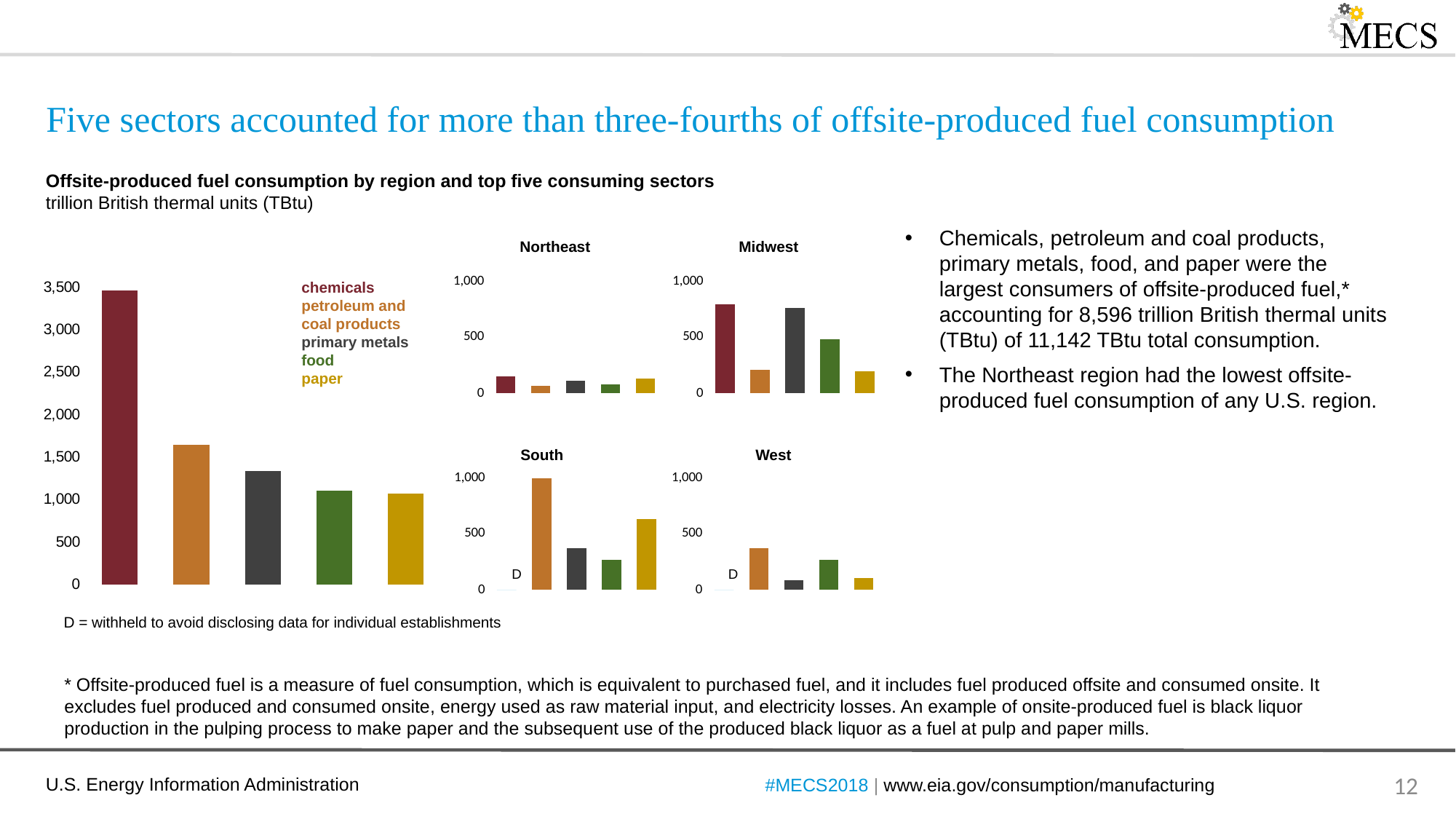
In the large chart on the left, which sector has the highest offsite-produced fuel consumption? chemicals In the Midwest chart, is the value for chemicals greater or less than 500? greater In the large chart on the left, how many sectors are plotted? 5 In the large chart on the left, is the value for primary metals greater or less than 1,500? less What kind of chart is the large chart on the left of the slide? bar chart In the West chart, is the value for petroleum and coal products greater or less than 500? less In the South chart, which sector has the highest value? petroleum and coal products In the large chart on the left, which is larger: petroleum and coal products or primary metals? petroleum and coal products In the South and West charts, which sector's value is marked D (withheld)? chemicals